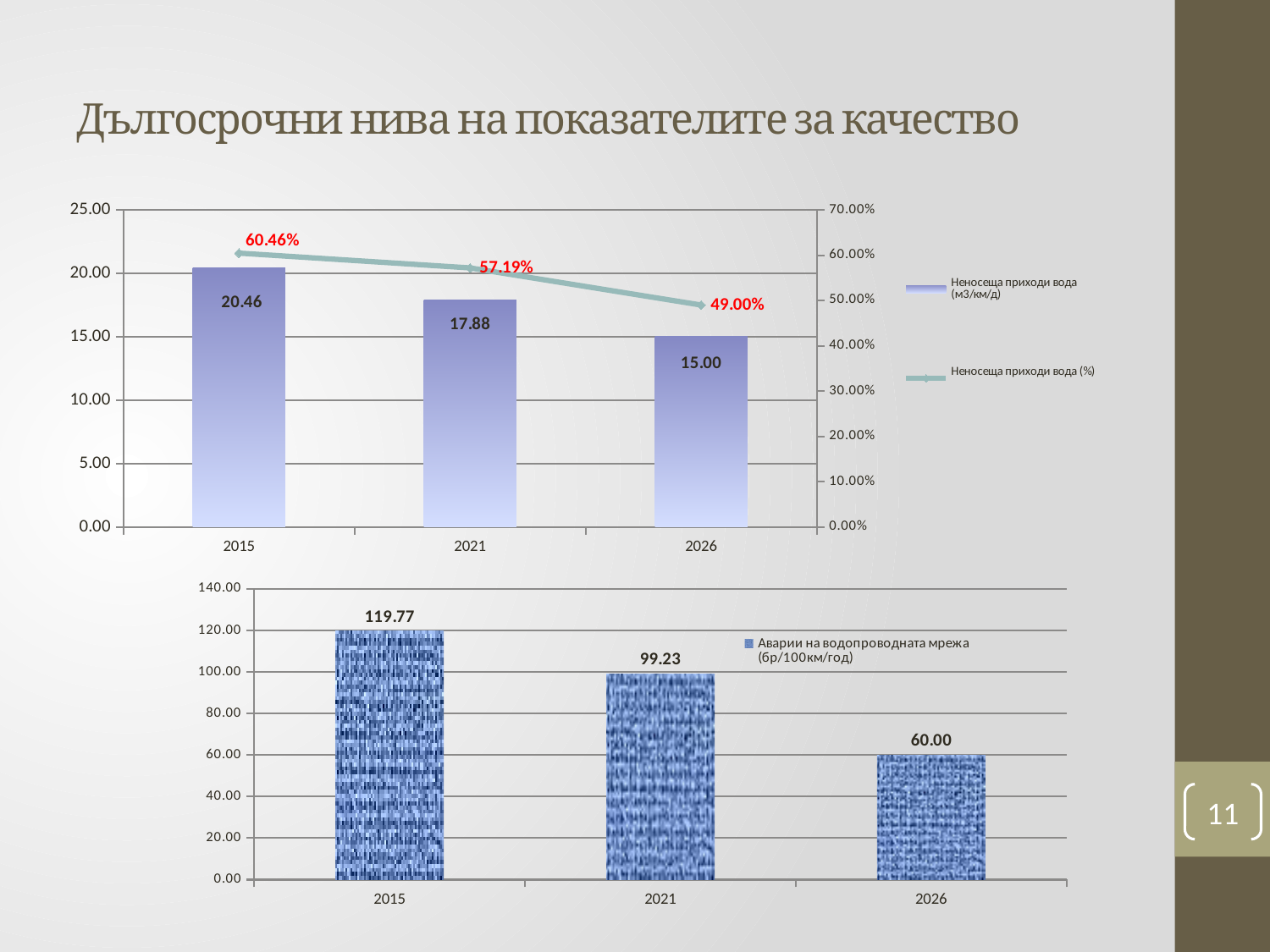
In the top chart, what percentage does the line show for 2021? 57.19% In the bottom chart, which year has the highest value? 2015 In the bottom chart, what is the difference between the values for 2015 and 2026? 59.77 In the top chart, which year has the lowest bar value? 2026 In the bottom chart, what is the value for 2021? 99.23 What kind of chart is the bottom chart? bar chart In the top chart, what percentage does the line show for 2026? 49.00% In the bottom chart, how many years are shown on the x axis? 3 In the top chart, how many series does the legend list? 2 In the top chart, do the line values rise or fall from 2015 to 2026? fall In the top chart, what is the value of the bar for 2015? 20.46 In the top chart, what is the difference between the bar values for 2015 and 2026? 5.46